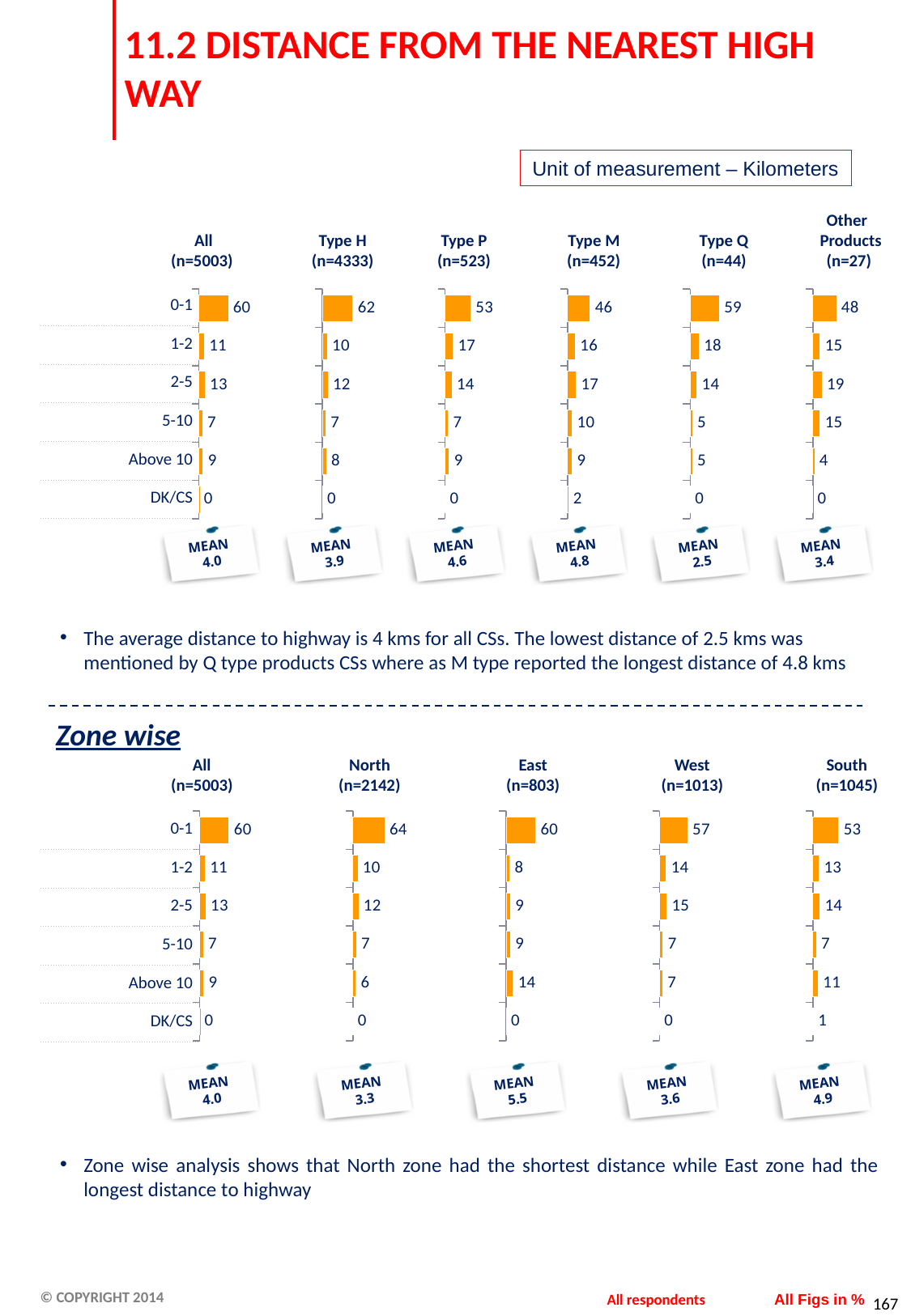
In the Zone wise charts, what is the value for the Above 10 km category in the East (n=803) chart? 14 In the top set of charts, what is the value for the 2-5 km category in the Other Products (n=27) chart? 19 In the top set of charts, which distance category has the highest value in the Type M (n=452) chart? 0-1 In the top set of charts, which distance category has the lowest value in the Type Q (n=44) chart? DK/CS How many distance categories are shown in each of the Zone wise charts? 6 In the top set of charts, which is larger: the 1-2 km value for Type P or the 1-2 km value for Type H? Type P In the Zone wise charts, what is the value for the 0-1 km category in the South (n=1045) chart? 53 In the Zone wise charts, which is larger: the 2-5 km value for West or the 2-5 km value for East? West In the top set of charts, what is the value for the 0-1 km category in the Type H (n=4333) chart? 62 In the Zone wise charts, what is the difference between the 0-1 km values of the North chart and the West chart? 7 What type of chart is used to show the distance distribution for each group on this slide? Bar chart In the top set of charts, what is the difference between the 0-1 km values of the Type H chart and the Type M chart? 16